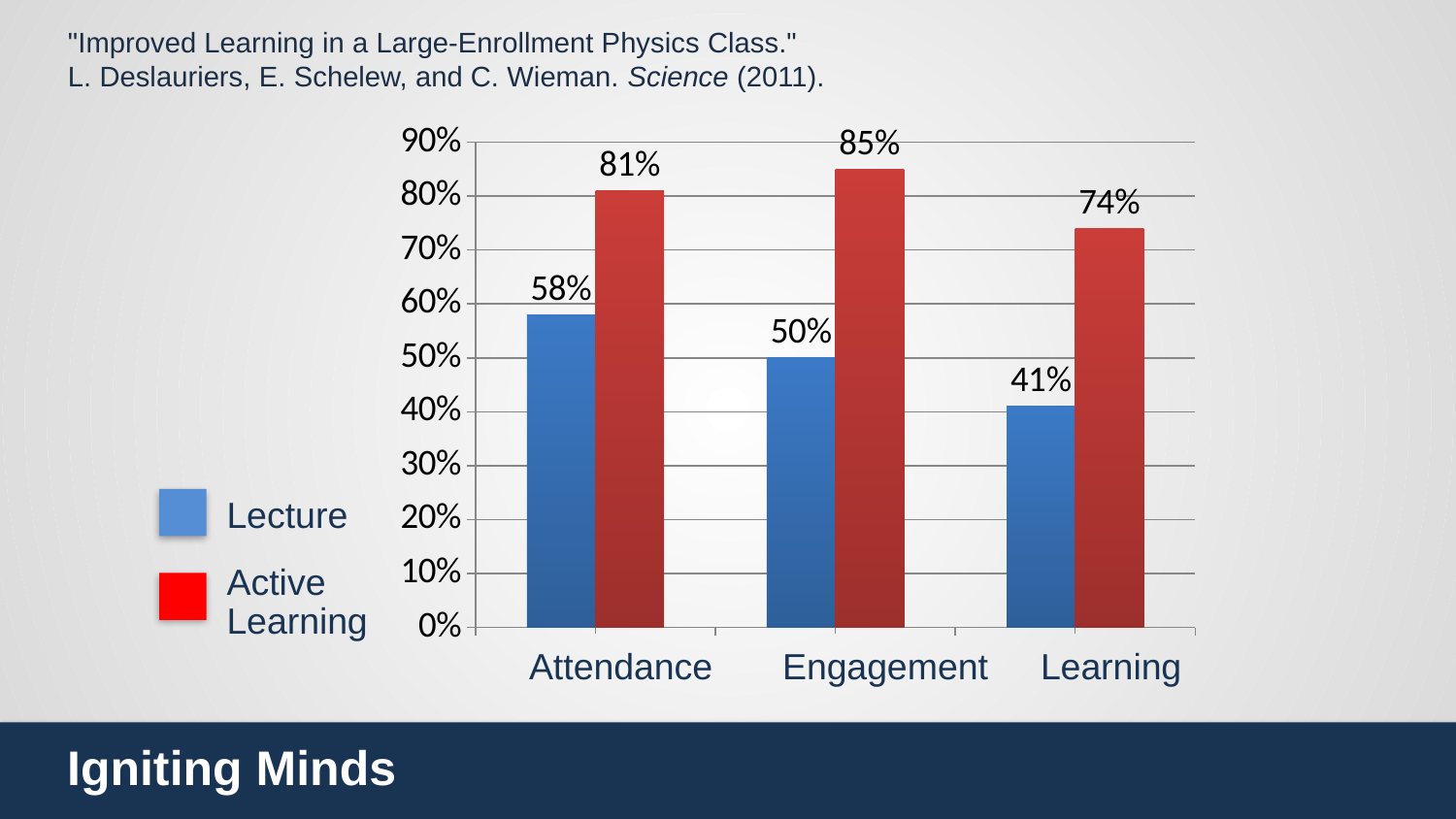
How many categories are shown on the x axis? 3 What is the Active Learning value for Learning? 74% Which category has the highest Active Learning value? Engagement What is the Active Learning value for Engagement? 85% What is the Lecture value for Learning? 41% What kind of chart is shown on the slide? Bar chart What is the difference between the Active Learning and Lecture values for Learning? 33% What is the Lecture value for Attendance? 58% Which category has the lowest Lecture value? Learning Which is larger for Engagement, the Lecture value or the Active Learning value? Active Learning What is the difference between the Active Learning and Lecture values for Attendance? 23% How many series does the legend list? 2